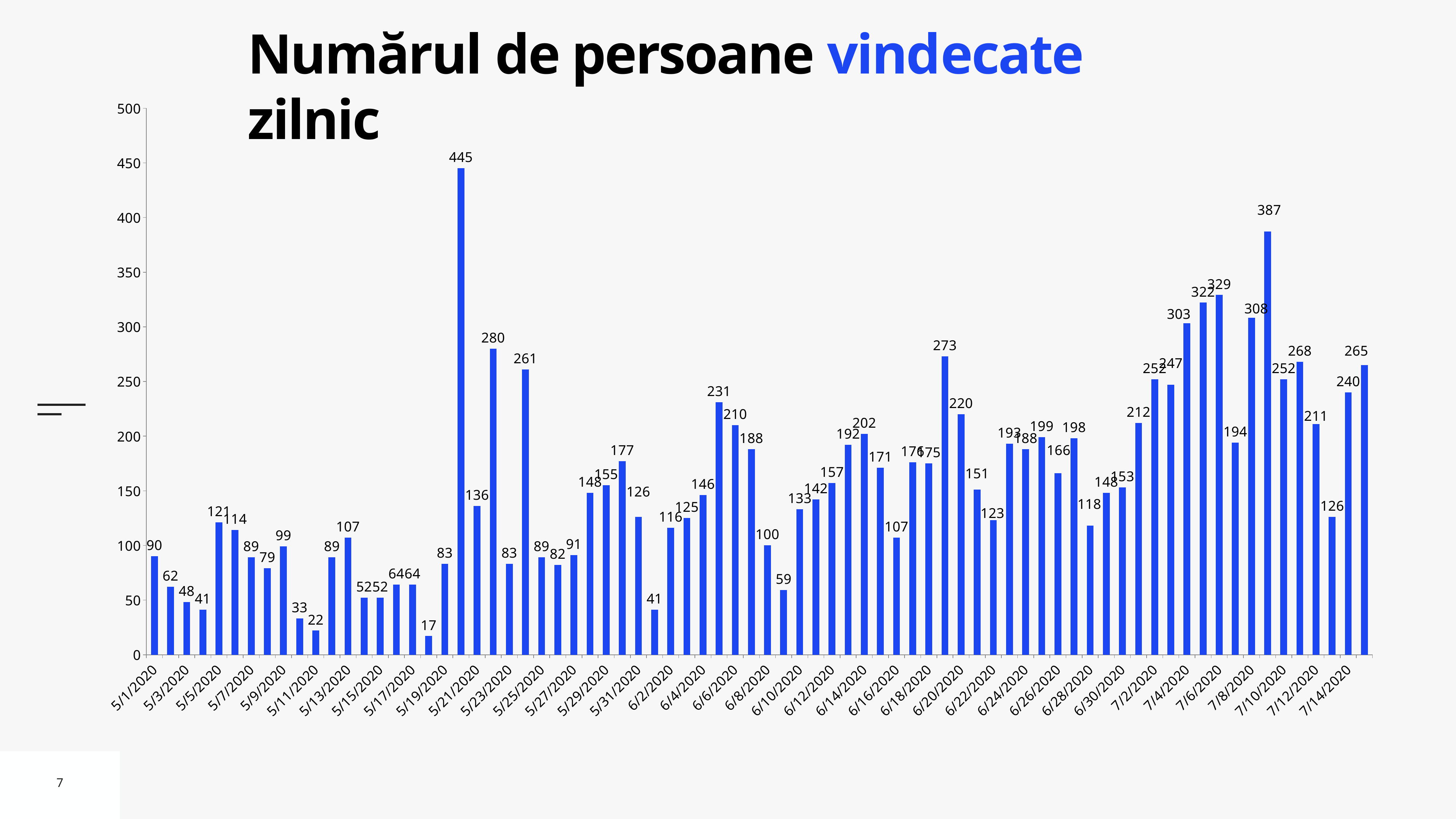
What is the value for 5/5/2020? 121 What is the title of the chart? Numărul de persoane vindecate zilnic What is the difference between the two highest values in the chart, 445 and 387? 58 What is the value for 5/13/2020? 107 What is the value for 5/1/2020? 90 Which is larger, the value for 5/5/2020 or the value for 5/13/2020? 5/5/2020 What type of chart is shown on the slide? bar chart What is the lowest daily value shown in the chart? 17 What is the highest daily value shown in the chart? 445 What is the value for 5/11/2020? 22 Is the value for 5/1/2020 greater or less than 100? less Overall, do the daily values rise or fall from early May to mid July? rise